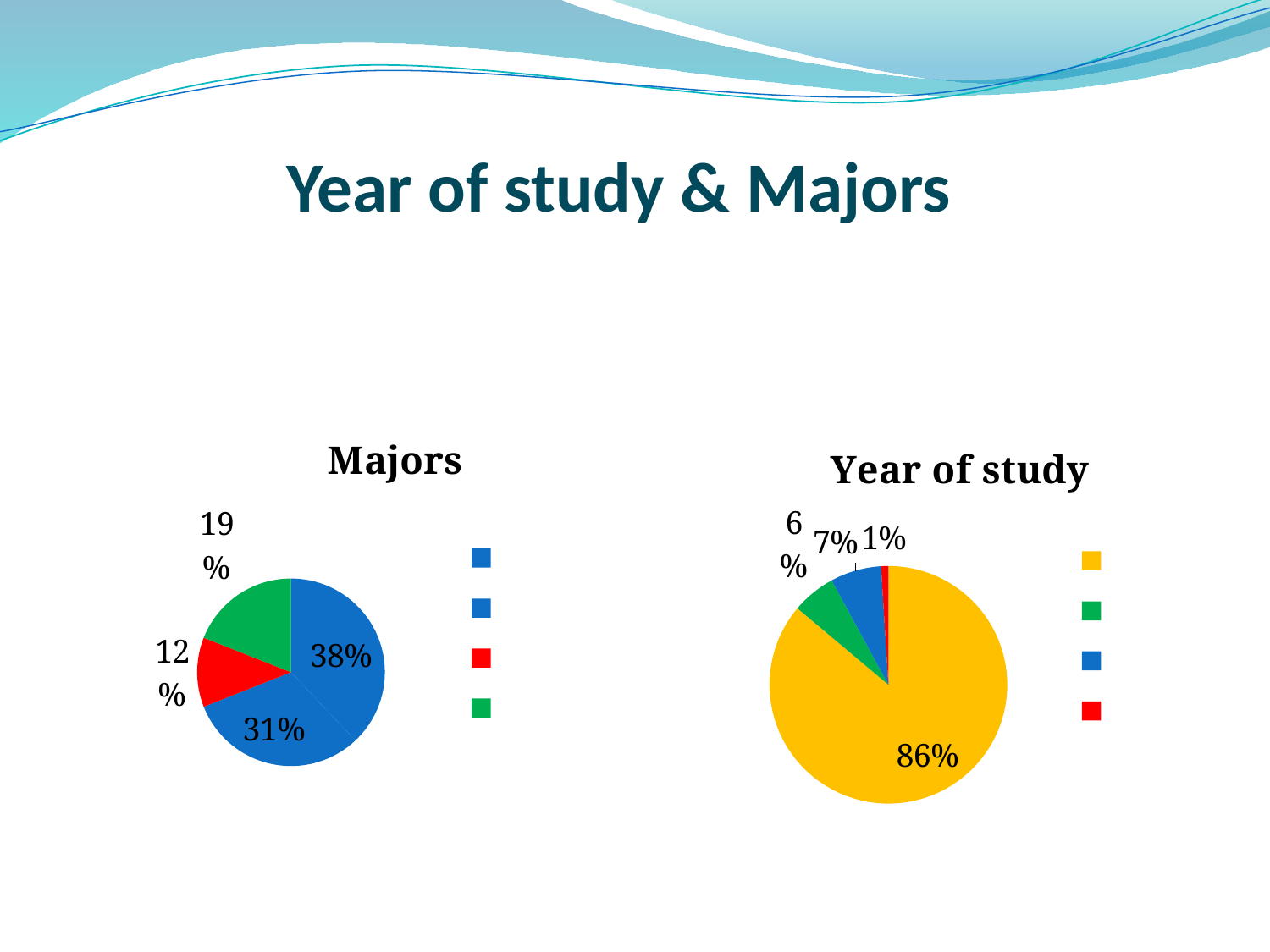
In the "Majors" chart, what is the difference between the 38% slice and the 31% slice? 7% In the "Majors" chart, what is the largest slice's percentage? 38% How many entries does the legend of the "Year of study" chart list? 4 In the "Majors" chart, what percentage is shown for the red slice? 12% What kind of chart is the "Majors" chart? pie chart In the "Majors" chart, what percentage is shown for the green slice? 19% In the "Majors" chart, what is the smallest slice's percentage? 12% How many slices does the "Majors" pie chart have? 4 In the "Year of study" chart, what percentage is shown for the yellow slice? 86% In the "Year of study" chart, what is the smallest slice's percentage? 1% In the "Year of study" chart, which is larger, the green slice or the blue slice? the blue slice (7%) In the "Year of study" chart, what is the difference between the yellow slice and the blue slice? 79%